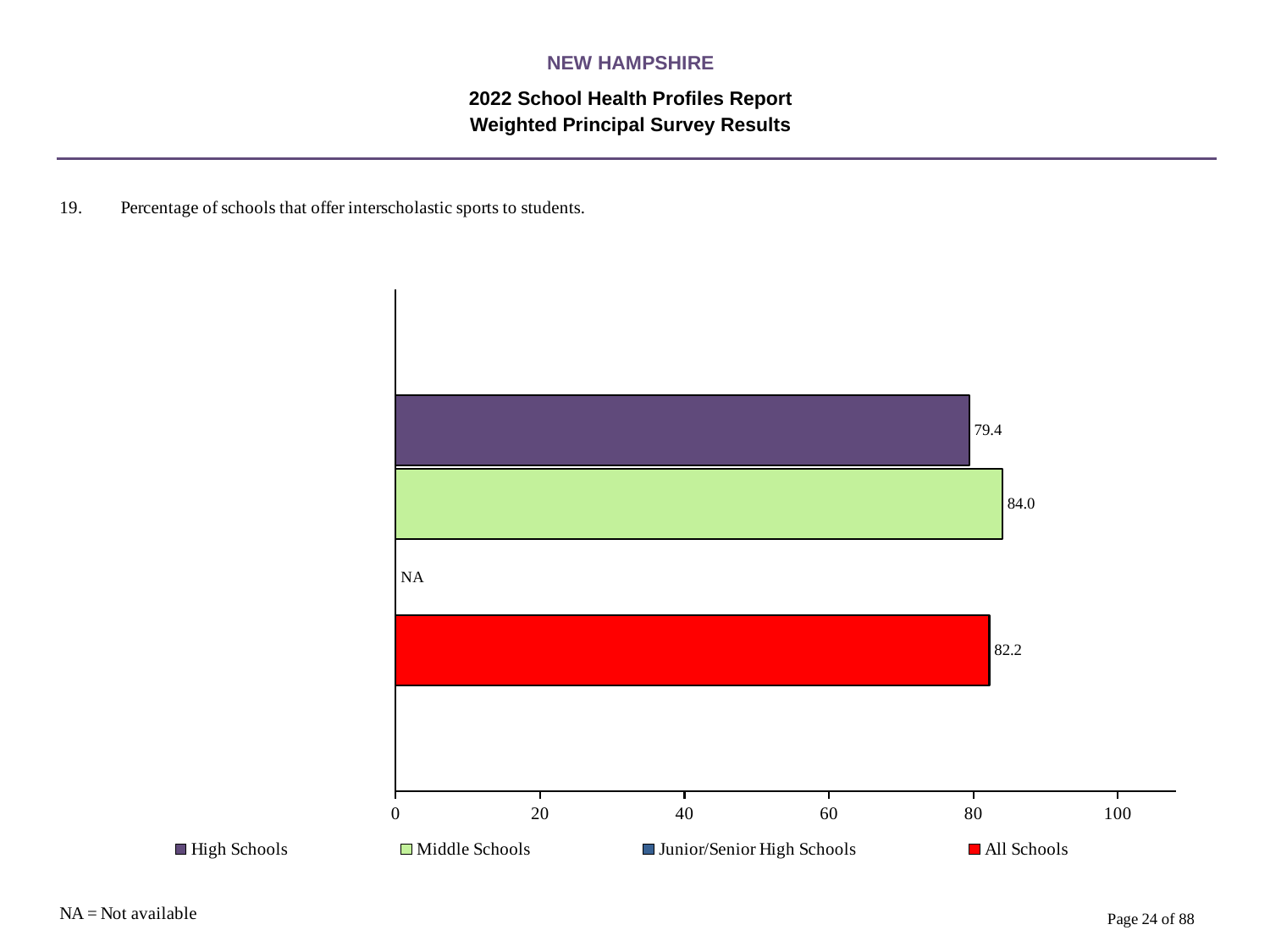
How many series does the legend list? 4 What kind of chart is shown on the slide? Bar chart What is the difference between the Middle Schools value and the High Schools value? 4.6 What colour is the bar for All Schools? Red Which school type has the highest percentage offering interscholastic sports? Middle Schools Is the value for Middle Schools greater or less than 80? greater What is the value shown for All Schools? 82.2 Among the school types with a plotted value, which has the lowest percentage? High Schools What is shown for Junior/Senior High Schools? NA What percentage of high schools offer interscholastic sports to students? 79.4 What is the value shown for Middle Schools? 84.0 Which is larger, the value for All Schools or the value for High Schools? All Schools